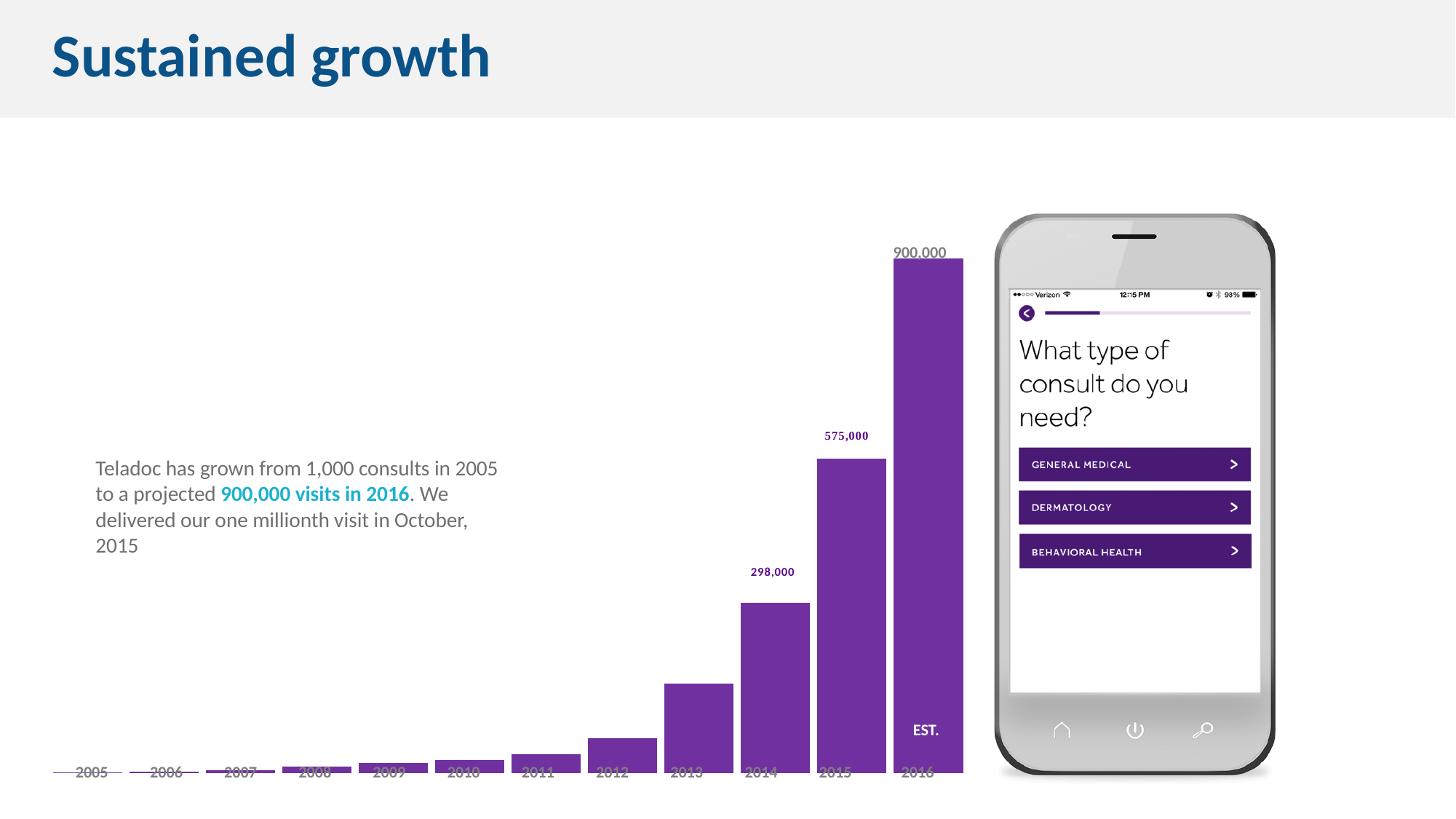
Which year has the highest bar? 2016 What kind of chart is shown on the slide? Bar chart What is the difference between the 2016 and 2015 values? 325,000 How many years are shown on the x axis? 12 Which year has the lowest bar? 2005 What is the difference between the 2015 and 2014 values? 277,000 Do the values rise or fall from 2005 to 2016? Rise Which year's bar is marked as an estimate (EST.)? 2016 Which is larger, the value for 2013 or the value for 2014? 2014 What value is shown for 2016? 900,000 What value is shown for 2014? 298,000 What value is shown for 2015? 575,000